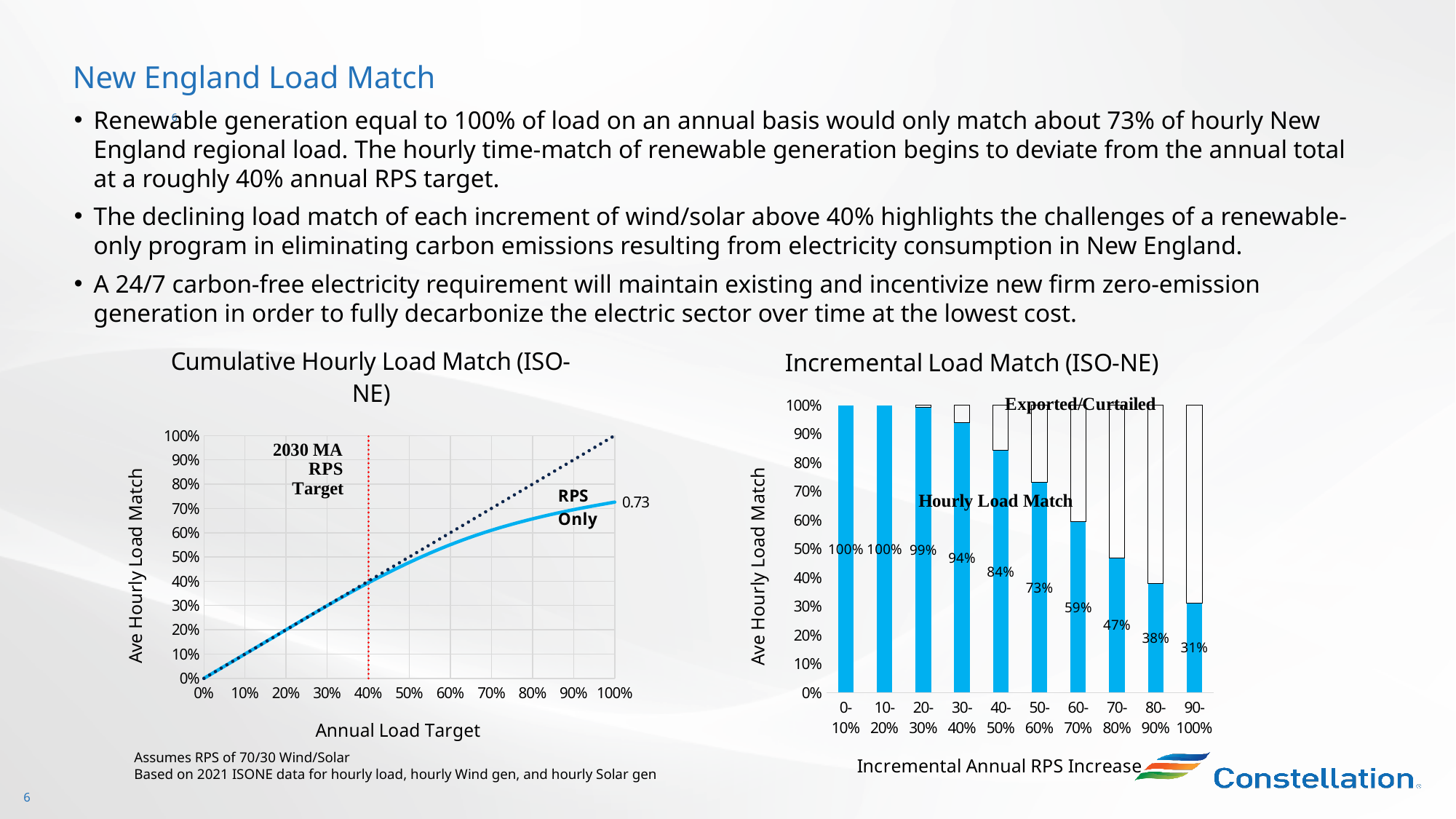
In the Cumulative Hourly Load Match (ISO-NE) chart, is the RPS Only value at an 80% annual load target greater or less than 70%? less In the Incremental Load Match (ISO-NE) chart, is the hourly load match for the 60-70% increment larger or smaller than that for the 80-90% increment? larger What kind of chart is the Incremental Load Match (ISO-NE) chart? bar chart In the Incremental Load Match (ISO-NE) chart, what is the difference between the hourly load match for the 40-50% increment and the 70-80% increment? 37% In the Incremental Load Match (ISO-NE) chart, what is the hourly load match value for the 90-100% increment? 31% In the Incremental Load Match (ISO-NE) chart, how many increment categories are shown on the x axis? 10 In the Incremental Load Match (ISO-NE) chart, what is the hourly load match value for the 30-40% increment? 94% In the Cumulative Hourly Load Match (ISO-NE) chart, at what annual load target is the 2030 MA RPS Target marked by the red dotted line? 40% In the Incremental Load Match (ISO-NE) chart, which increment has the lowest hourly load match? 90-100% In the Cumulative Hourly Load Match (ISO-NE) chart, what value is labeled at the end of the RPS Only line at a 100% annual load target? 0.73 In the Incremental Load Match (ISO-NE) chart, do the hourly load match values rise or fall as the increments move from 0-10% to 90-100%? fall In the Incremental Load Match (ISO-NE) chart, what is the hourly load match value for the 50-60% increment? 73%